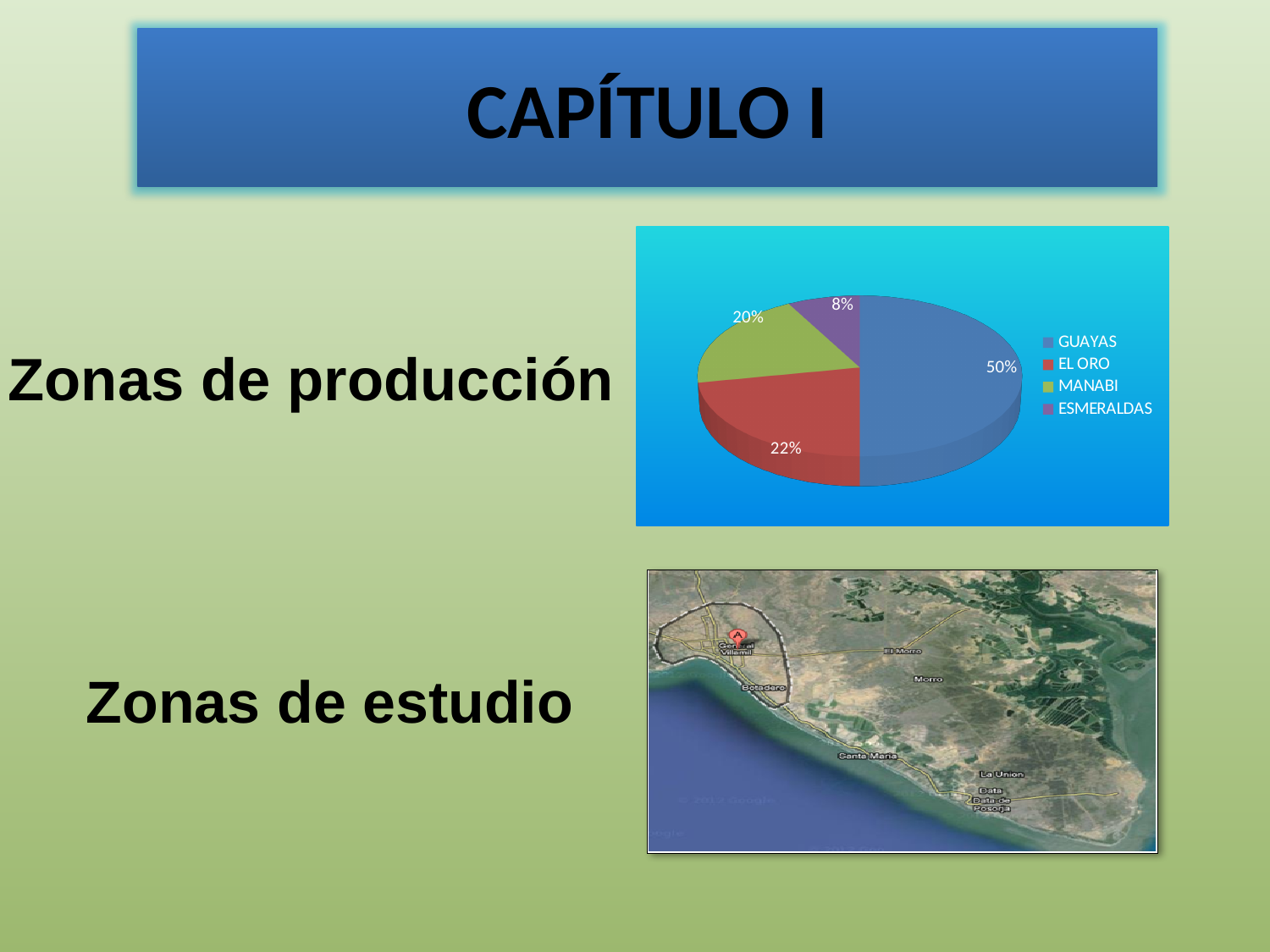
Which category has the largest slice of the pie chart? GUAYAS What share of the pie chart does GUAYAS have? 50% What kind of chart is shown next to "Zonas de producción"? pie chart What share of the pie chart does EL ORO have? 22% What is the difference in percentage points between GUAYAS and EL ORO in the pie chart? 28 What is the difference in percentage points between MANABI and ESMERALDAS in the pie chart? 12 Which has a larger share in the pie chart, EL ORO or MANABI? EL ORO Which category has the smallest slice of the pie chart? ESMERALDAS What colour is the GUAYAS slice in the pie chart? blue What share of the pie chart does ESMERALDAS have? 8% What share of the pie chart does MANABI have? 20% How many categories does the pie chart legend list? 4